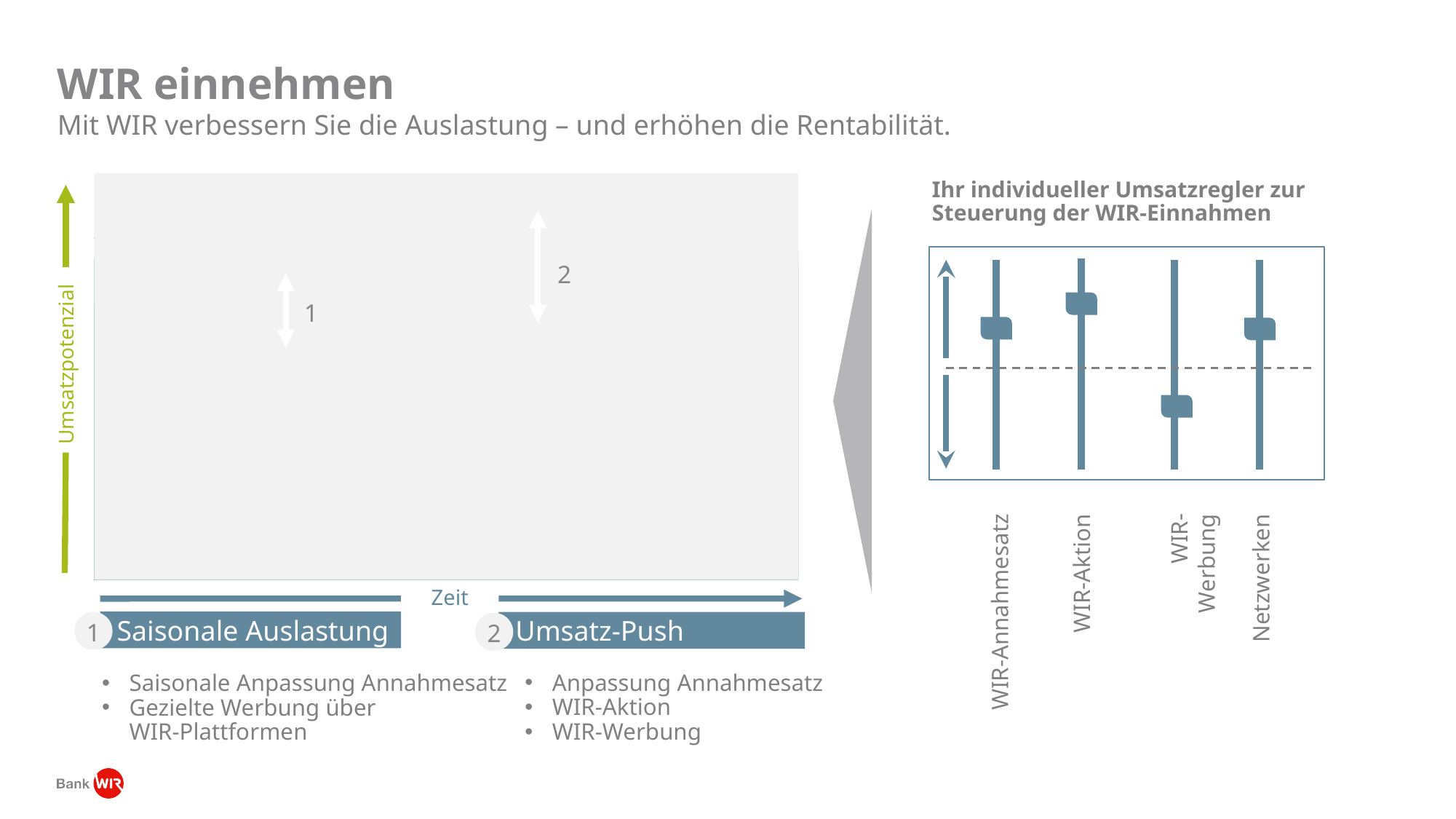
In the slider diagram on the right, which is set higher: WIR-Aktion or Netzwerken? WIR-Aktion In the slider diagram on the right, how many sliders are positioned above the dashed line? 3 In the slider diagram on the right, which slider is positioned below the dashed line? WIR-Werbung In the slider diagram on the right, which slider is set highest? WIR-Aktion In the slider diagram on the right, which is set higher: WIR-Annahmesatz or WIR-Werbung? WIR-Annahmesatz In the slider diagram on the right, how many sliders are shown? 4 On the left chart, what is the label of the vertical axis? Umsatzpotenzial In the slider diagram on the right, which slider is set lowest? WIR-Werbung On the left chart, what is the label of the horizontal axis? Zeit